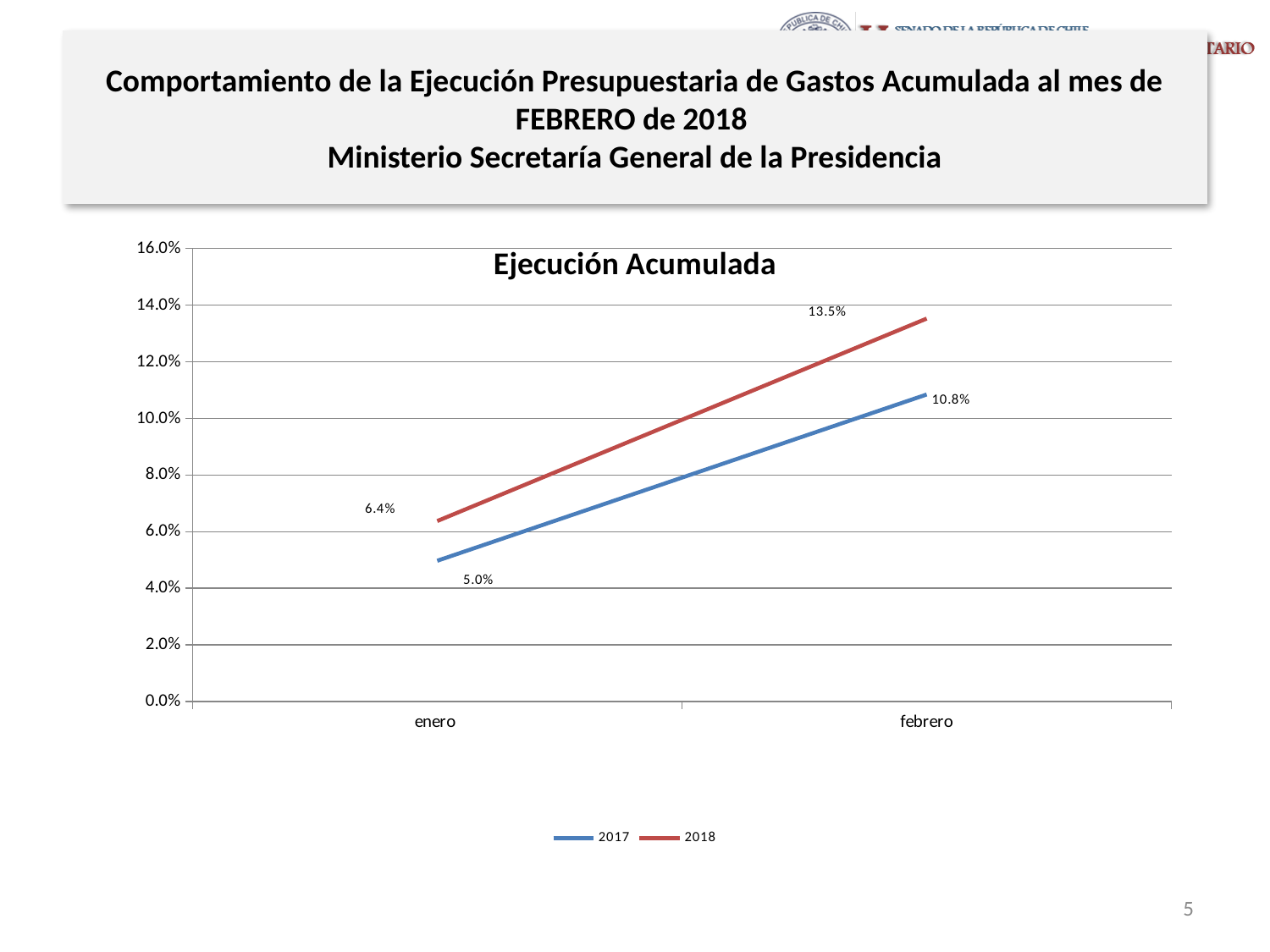
Which series has the higher value in febrero, 2017 or 2018? 2018 What is the value for 2017 in febrero? 10.8% Does the 2017 series rise or fall from enero to febrero? Rise What kind of chart is shown? Line chart What is the difference between the 2018 and 2017 values in enero? 1.4% How many series does the legend list? 2 What is the value for 2018 in enero? 6.4% What is the value for 2017 in enero? 5.0% What is the title of the chart? Ejecución Acumulada What is the value for 2018 in febrero? 13.5% How many categories are shown on the x axis? 2 What is the difference between the 2018 and 2017 values in febrero? 2.7%